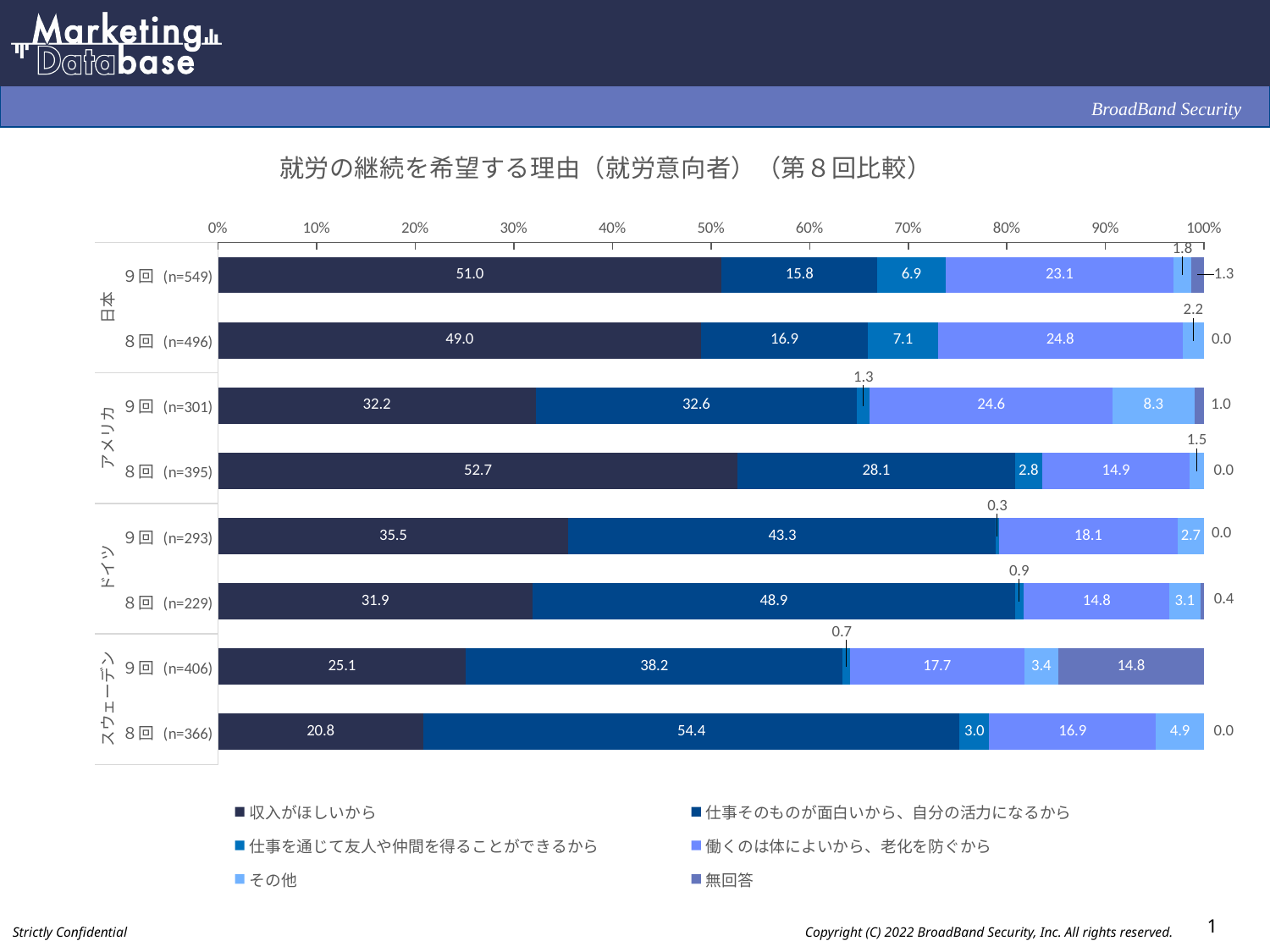
Which row has the lowest value for 収入がほしいから? スウェーデン 8回 (n=366) How many series does the legend list? 6 What is the difference in 収入がほしいから between 日本 9回 (n=549) and 日本 8回 (n=496)? 2.0 What is the title of the chart? 就労の継続を希望する理由（就労意向者）（第８回比較） Which is larger: 仕事そのものが面白いから、自分の活力になるから for ドイツ 9回 (n=293) or for ドイツ 8回 (n=229)? ドイツ 8回 (n=229) What is the value of 無回答 for スウェーデン 9回 (n=406)? 14.8 What is the value of 仕事そのものが面白いから、自分の活力になるから for スウェーデン 8回 (n=366)? 54.4 What type of chart is shown on the slide? Stacked bar chart How many bars (survey rows) are plotted in the chart? 8 What is the value of 収入がほしいから for 日本 9回 (n=549)? 51.0 What is the value of 働くのは体によいから、老化を防ぐから for アメリカ 9回 (n=301)? 24.6 Which row has the highest value for 収入がほしいから? アメリカ 8回 (n=395)